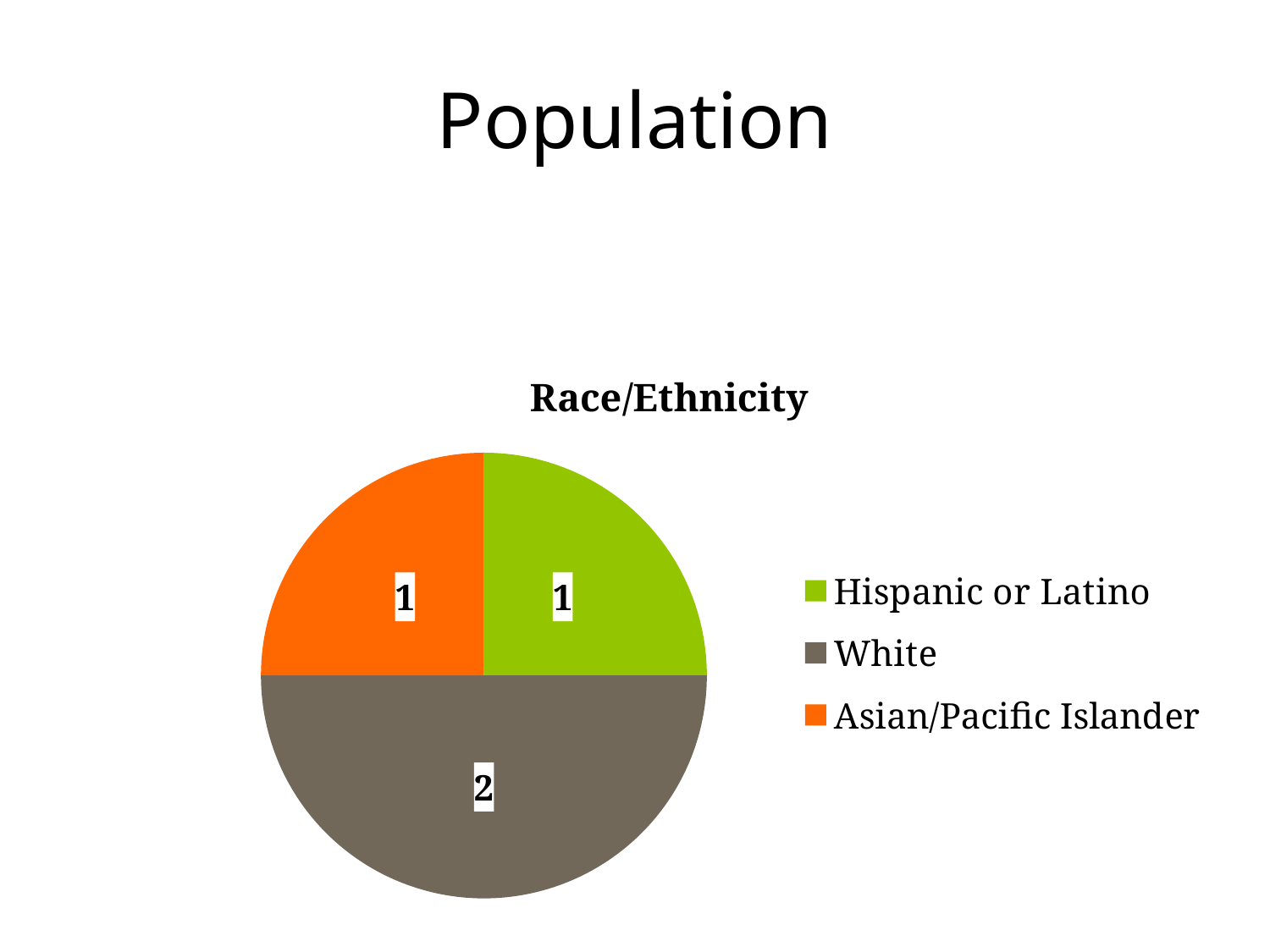
What is the title of the chart? Race/Ethnicity Which is larger, the value for White or the value for Asian/Pacific Islander? White What is the value for Asian/Pacific Islander? 1 What colour is the slice for Asian/Pacific Islander? orange What is the total of all slices in the pie chart? 4 Which category has the largest slice? White What is the value for Hispanic or Latino? 1 What is the difference between the value for White and the value for Hispanic or Latino? 1 What share of the pie does the White slice represent? 50% What type of chart is shown on the slide? pie chart What is the value for White? 2 How many categories does the pie chart show? 3